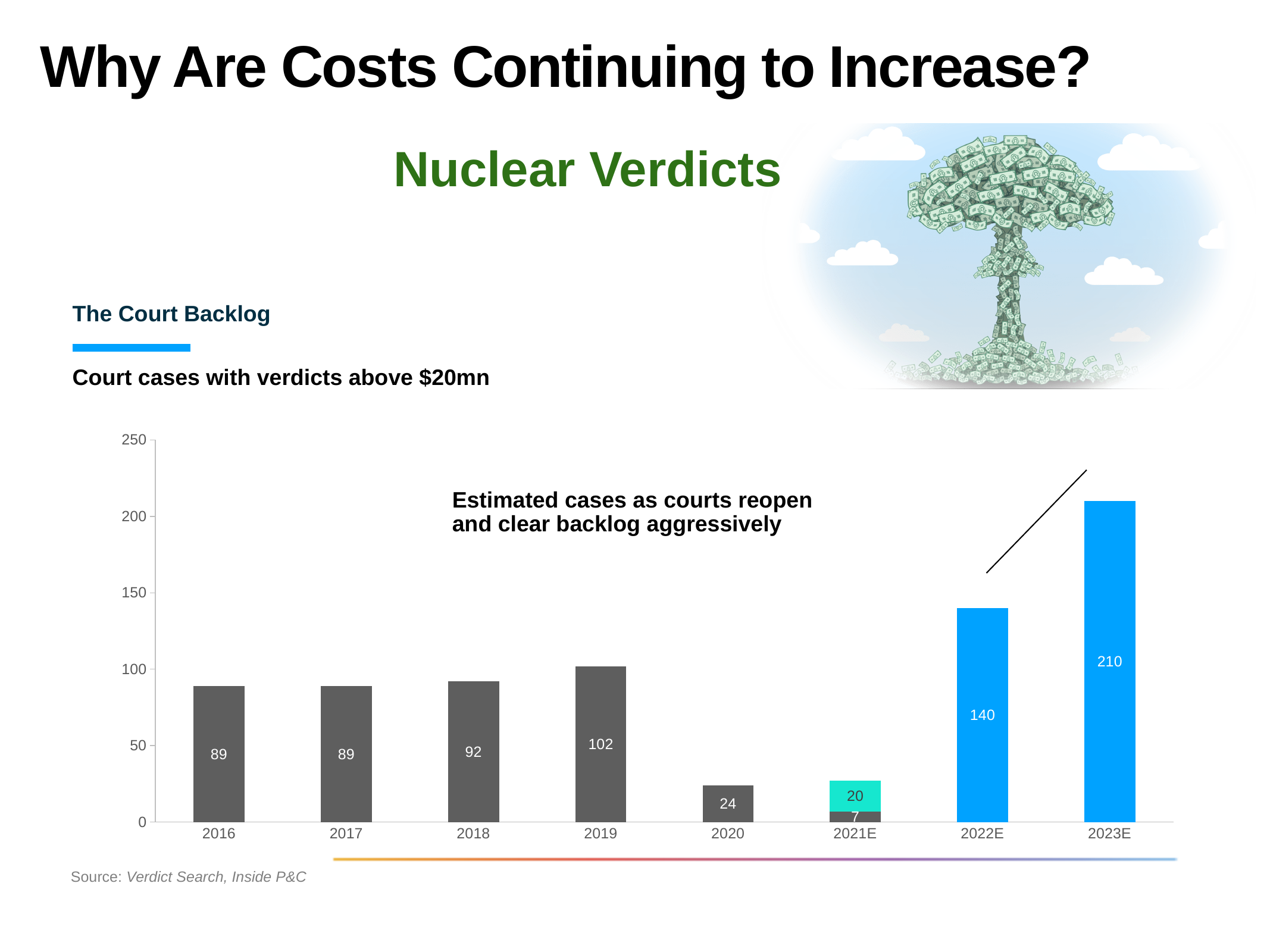
What kind of chart is shown? bar chart How many years are shown on the x axis? 8 Which year has the highest value? 2023E Which year has the lowest total value? 2020 What is the value for 2020? 24 What is the value for 2022E? 140 What is the value for 2019? 102 What is the value for 2023E? 210 What is the difference between the values for 2019 and 2018? 10 Which is larger, the value for 2018 or the value for 2020? 2018 What is the total of the stacked bar for 2021E? 27 What is the difference between the values for 2023E and 2022E? 70